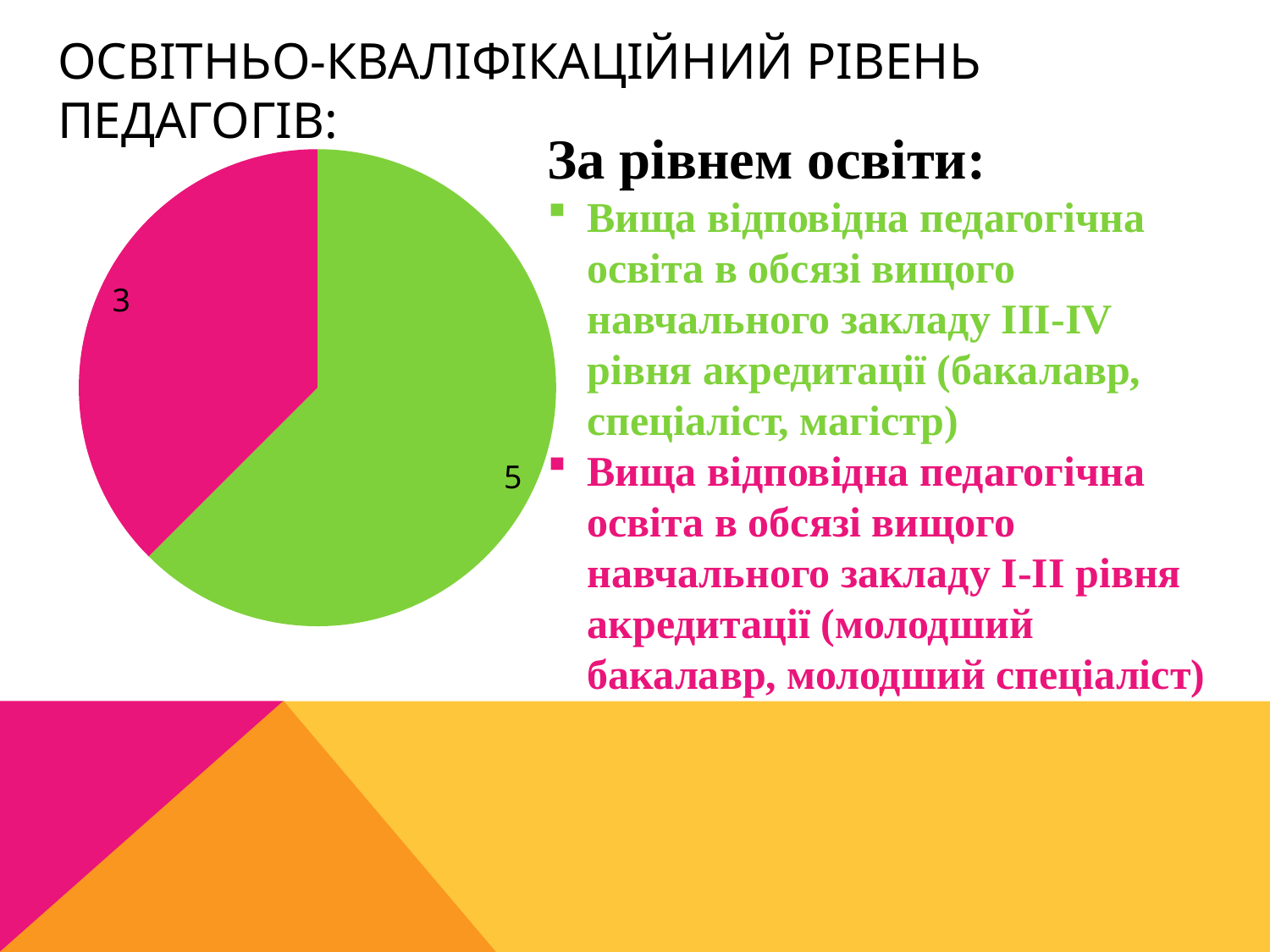
What kind of chart is shown on the slide? pie chart What is the difference between the green slice and the pink slice of the pie chart? 2 What share of the pie does the green slice (value 5) represent? 62.5% Which slice of the pie chart is the largest? the green slice (III-IV рівня акредитації), 5 What is the value of the green slice of the pie chart? 5 Which colour represents teachers with education from an institution of I-II accreditation level? pink What is the value for teachers with higher pedagogical education from an institution of III-IV accreditation level (бакалавр, спеціаліст, магістр)? 5 Which slice of the pie chart is the smallest? the pink slice (I-II рівня акредитації), 3 How many slices does the pie chart have? 2 Which is larger: the value for III-IV accreditation level or the value for I-II accreditation level? III-IV accreditation level What is the value for teachers with higher pedagogical education from an institution of I-II accreditation level (молодший бакалавр, молодший спеціаліст)? 3 What is the value of the pink slice of the pie chart? 3